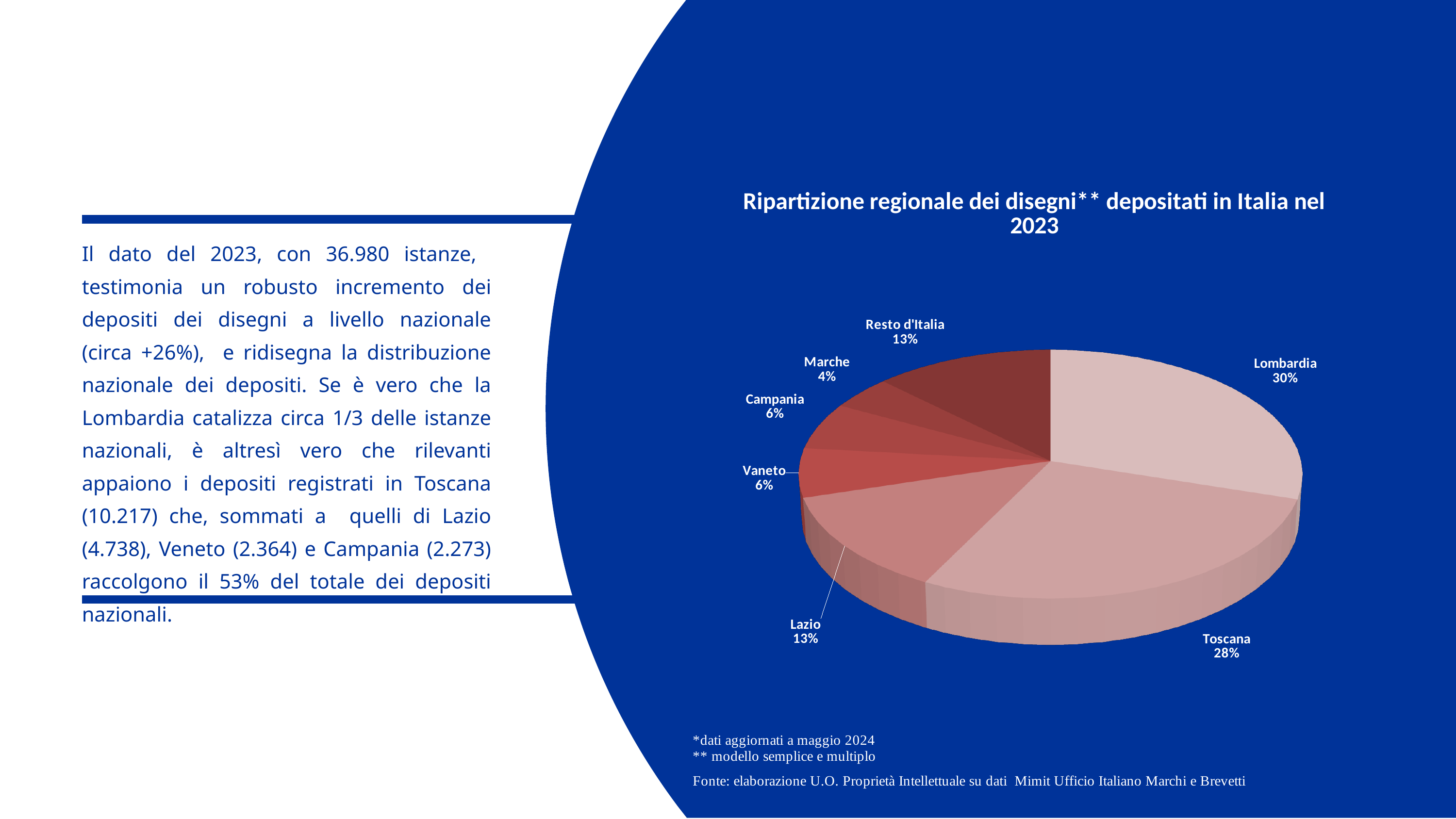
What is the title of the chart? Ripartizione regionale dei disegni** depositati in Italia nel 2023 What is the difference in percentage points between Lombardia and Toscana? 2 What share of the pie does Lombardia hold? 30% Which is larger, the share for Lazio or the share for Campania? Lazio What share is labelled for Resto d'Italia? 13% What type of chart is shown on the slide? Pie chart What percentage is shown for Marche? 4% What is the value labelled for Lazio? 13% What percentage is shown for Toscana? 28% How many slices does the pie chart have? 7 Which slice of the pie is the smallest? Marche Which region has the largest slice of the pie? Lombardia